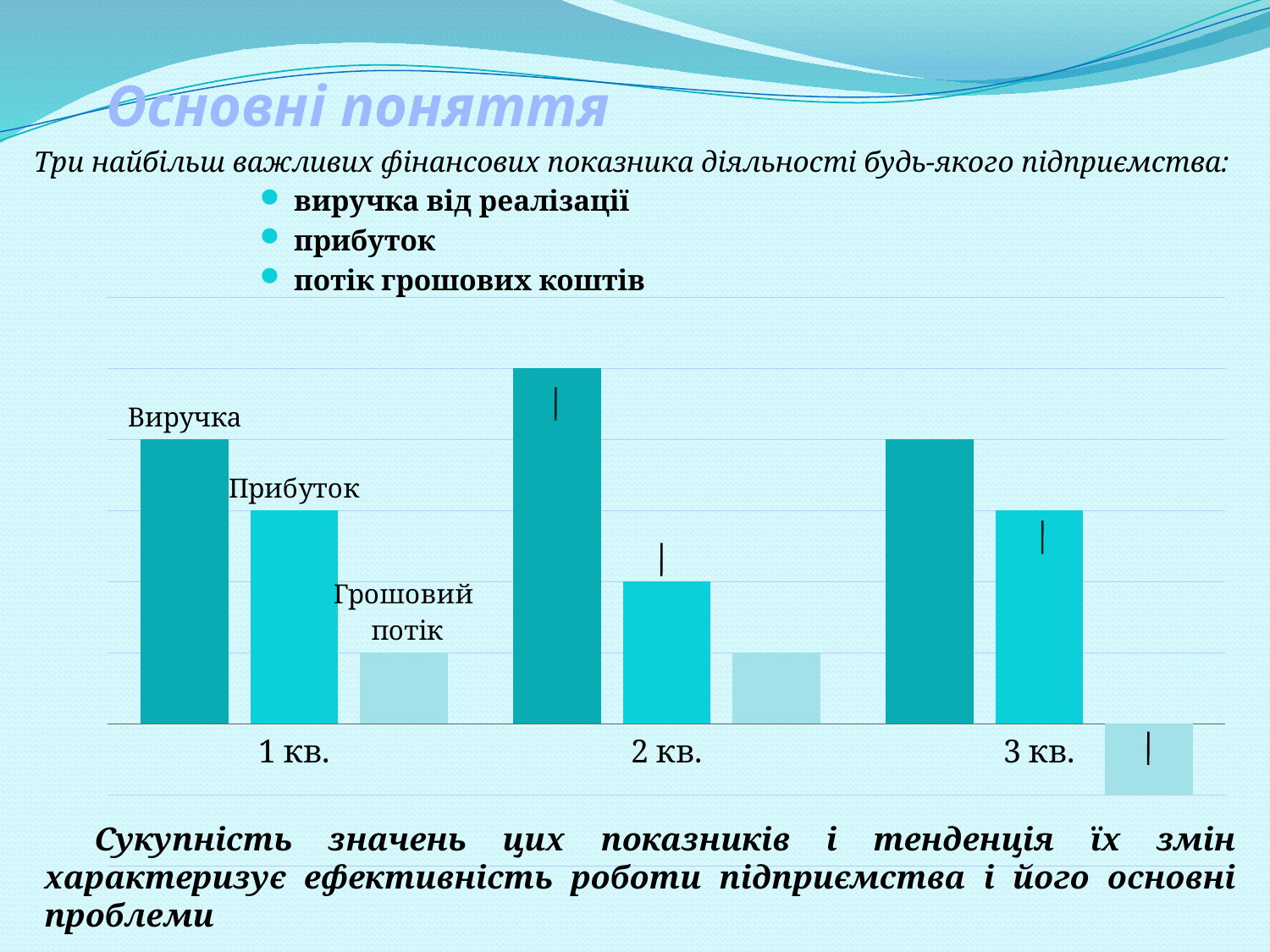
In 2 кв., which indicator has the tallest bar? Виручка In 1 кв., which indicator has the shortest bar? Грошовий потік Does Прибуток rise or fall from 1 кв. to 2 кв.? fall In which quarter is Виручка highest? 2 кв. In which quarter is Грошовий потік lowest? 3 кв. How many indicators (series) are plotted in the chart? 3 What kind of chart is shown on the slide? bar chart What are the three series labels shown on the chart? Виручка, Прибуток, Грошовий потік How many quarters (categories) are shown on the x axis of the chart? 3 In 1 кв., which is larger: Виручка or Прибуток? Виручка In which quarter is Прибуток lowest? 2 кв. Is the Грошовий потік bar for 3 кв. above or below the horizontal axis? below